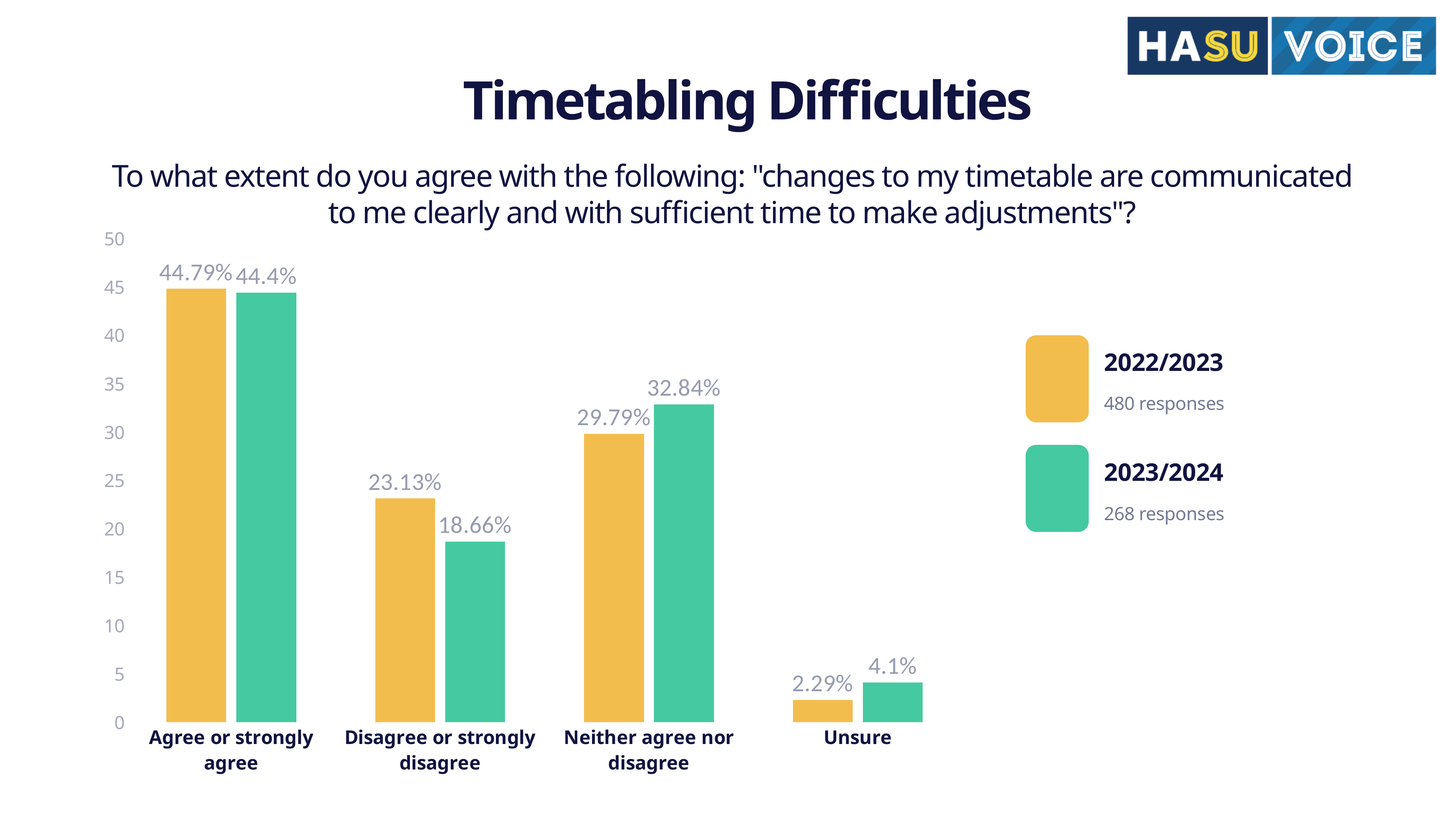
How many categories are shown on the x axis? 4 What kind of chart is shown on the slide? Bar chart What is the 2022/2023 value for "Agree or strongly agree"? 44.79% How many series does the legend list? 2 What is the 2023/2024 value for "Disagree or strongly disagree"? 18.66% Which category has the lowest value for 2022/2023? Unsure Which category has the highest value for 2023/2024? Agree or strongly agree For "Neither agree nor disagree", which series has the larger value, 2022/2023 or 2023/2024? 2023/2024 How many responses does the legend give for 2023/2024? 268 responses What is the 2023/2024 value for "Neither agree nor disagree"? 32.84% What is the 2022/2023 value for "Unsure"? 2.29% What is the difference between the 2022/2023 and 2023/2024 values for "Disagree or strongly disagree"? 4.47%